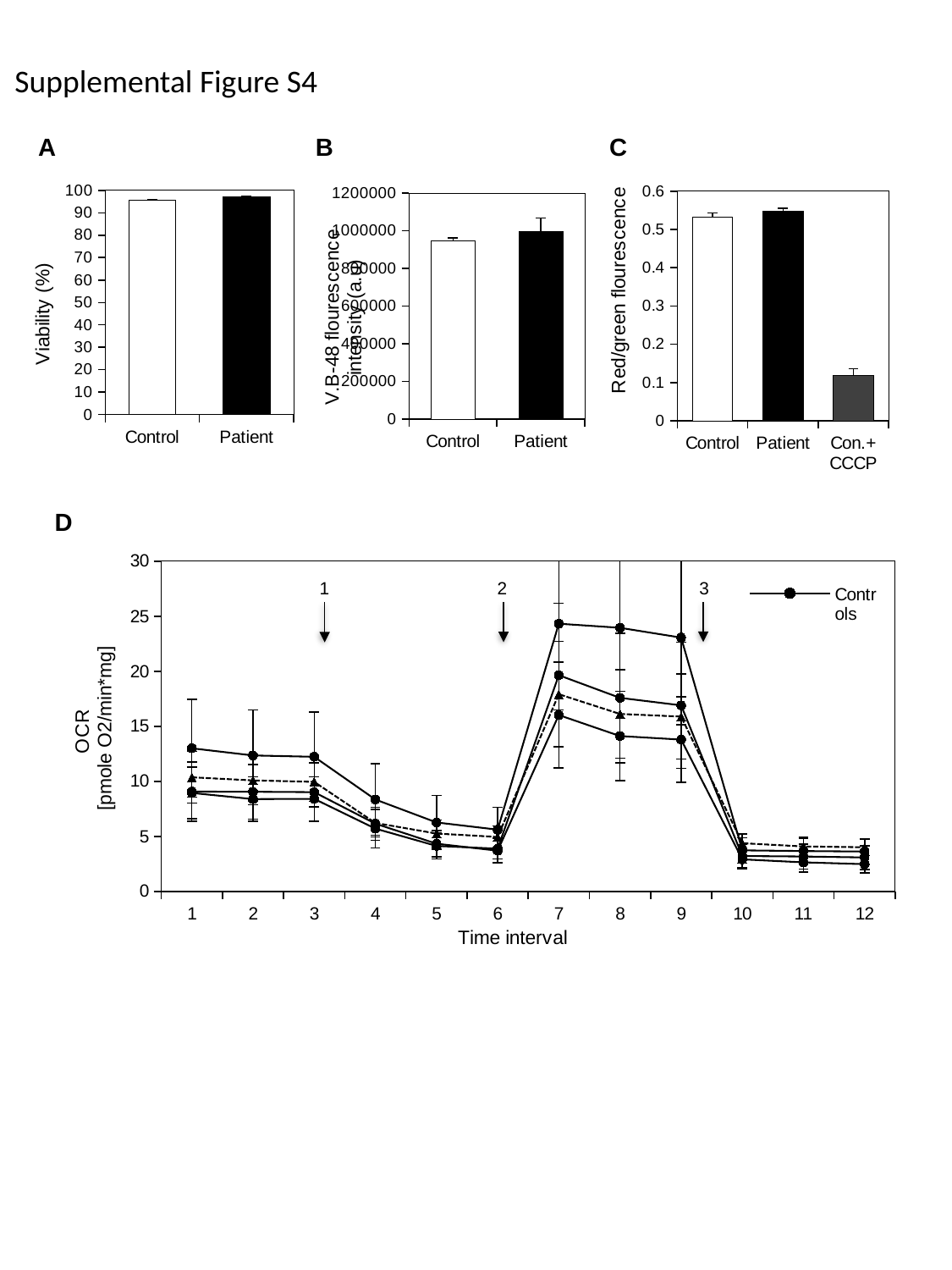
In chart C, is the value for Control larger or smaller than the value for Con.+CCCP? larger What kind of chart is chart D? line chart In chart D, do the OCR values rise or fall from time interval 1 to time interval 6? fall In chart B, is the value for Patient greater or less than 1200000? less In chart B, is the value for Control greater or less than 800000? greater In chart A (Viability), is the value for Control greater or less than 90? greater What kind of chart is chart B? bar chart In chart C, how many categories are shown on the x axis? 3 In chart D, how many time intervals are shown on the x axis? 12 In chart C (Red/green flourescence), which category has the lowest value? Con.+CCCP In chart A (Viability), how many categories are shown on the x axis? 2